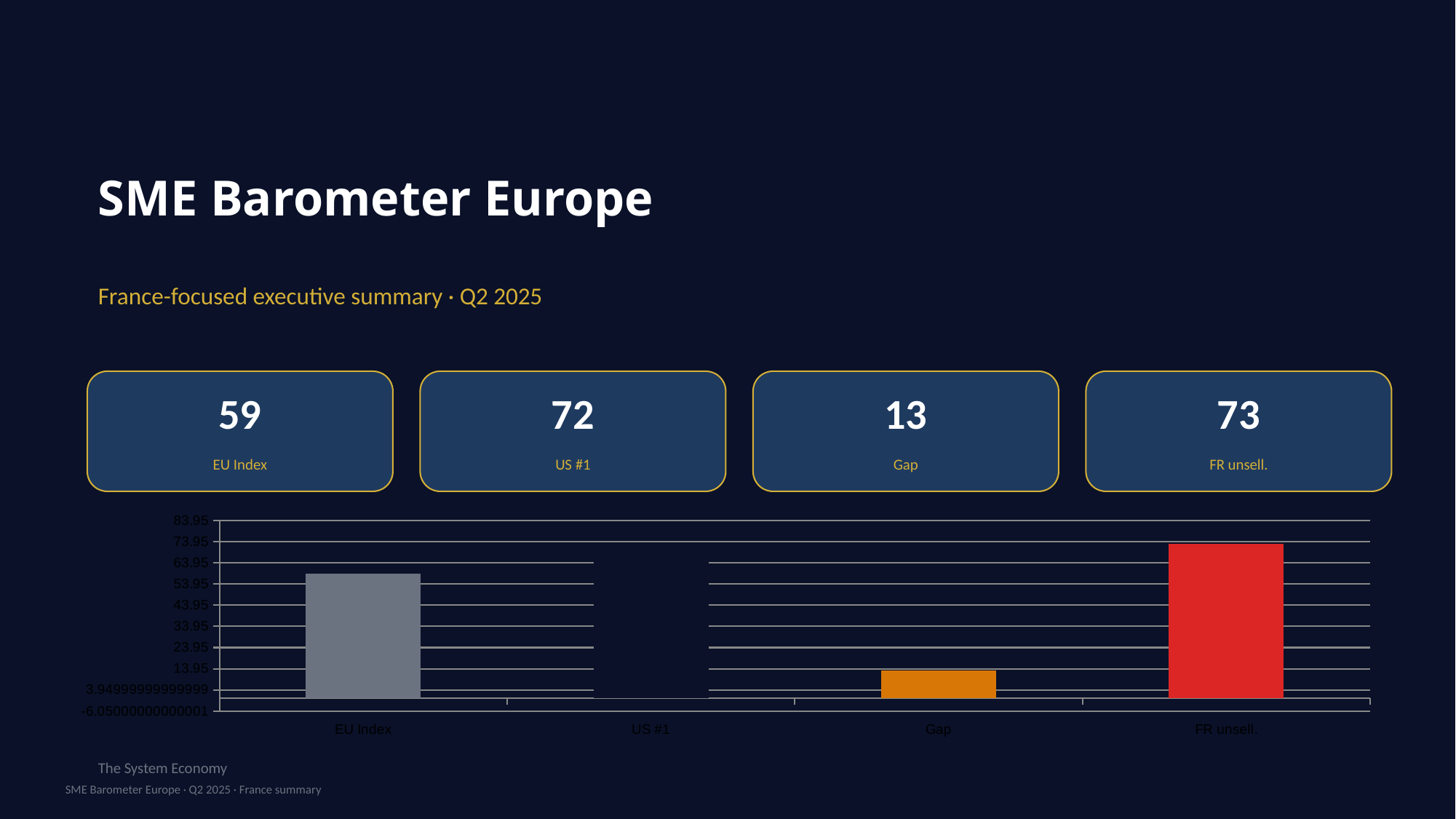
What kind of chart is shown on the slide? bar chart Is the bar for EU Index greater or less than 63.95? less What colour is the bar for FR unsell.? red Which category has the tallest bar in the chart? FR unsell. Is the bar for Gap greater or less than 23.95? less Is the bar for EU Index greater or less than 53.95? greater Which bar is taller, FR unsell. or EU Index? FR unsell. How many categories are shown on the x axis of the bar chart? 4 Which bar is taller, EU Index or Gap? EU Index What colour is the bar for Gap? orange